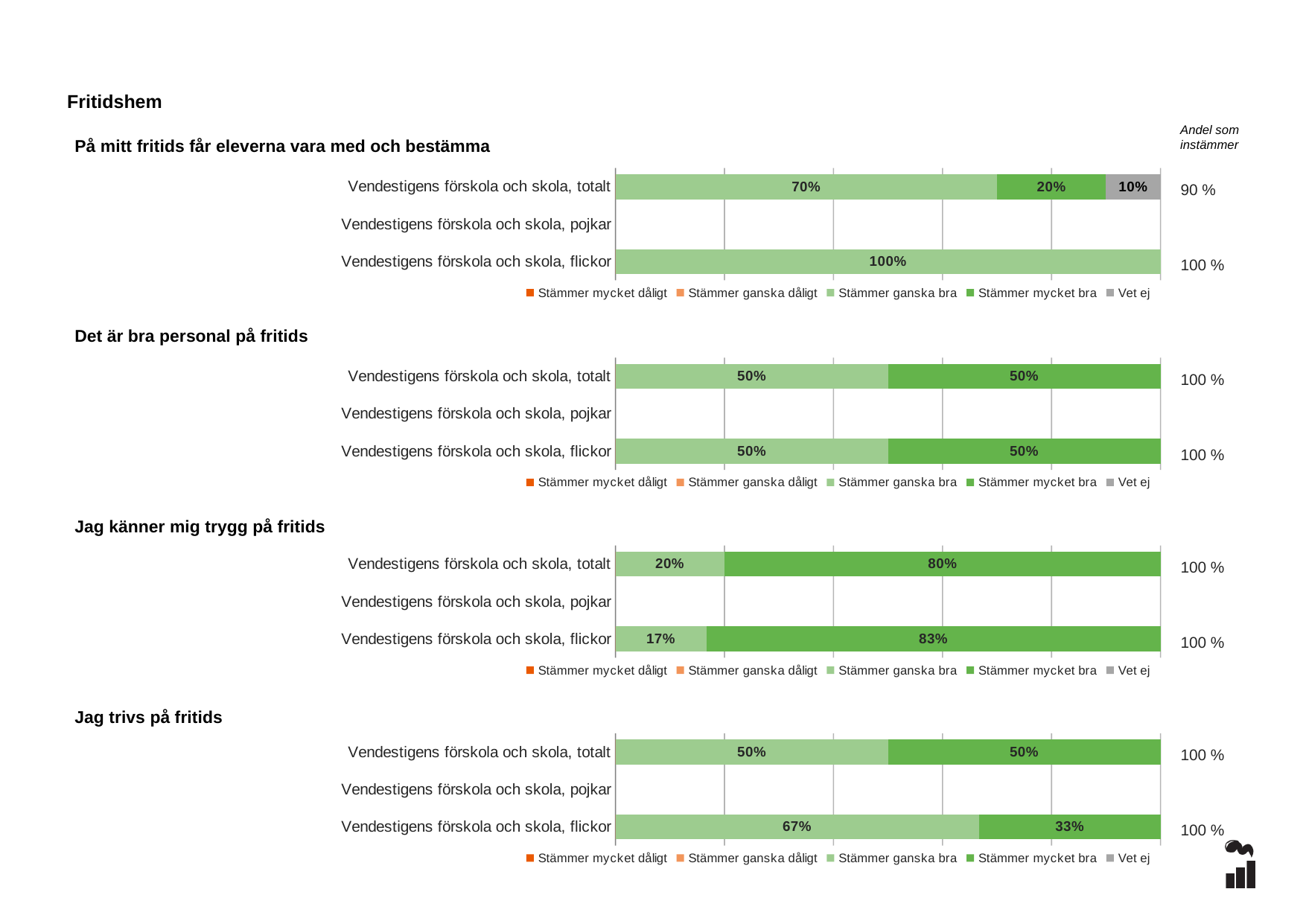
In the chart 'Jag känner mig trygg på fritids', what is the value of 'Stämmer mycket bra' for 'Vendestigens förskola och skola, flickor'? 83% How many categories are shown on the y axis of the chart 'Det är bra personal på fritids'? 3 In the chart 'På mitt fritids får eleverna vara med och bestämma', what is the value of 'Vet ej' for 'Vendestigens förskola och skola, totalt'? 10% In the chart 'Jag trivs på fritids', what is the value of 'Stämmer ganska bra' for 'Vendestigens förskola och skola, flickor'? 67% In the chart 'På mitt fritids får eleverna vara med och bestämma', what is the value of 'Stämmer ganska bra' for 'Vendestigens förskola och skola, flickor'? 100% In the chart 'På mitt fritids får eleverna vara med och bestämma', what is the value of 'Stämmer ganska bra' for 'Vendestigens förskola och skola, totalt'? 70% In the chart 'Det är bra personal på fritids', what is the value of 'Stämmer mycket bra' for 'Vendestigens förskola och skola, totalt'? 50% In the chart 'Jag känner mig trygg på fritids', what is the difference between 'Stämmer mycket bra' and 'Stämmer ganska bra' for 'Vendestigens förskola och skola, totalt'? 60% How many series does the legend of the chart 'Jag trivs på fritids' list? 5 In the chart 'På mitt fritids får eleverna vara med och bestämma', what is the 'Andel som instämmer' value shown for 'Vendestigens förskola och skola, totalt'? 90 % In the chart 'Jag trivs på fritids', which is larger for 'Vendestigens förskola och skola, flickor': 'Stämmer ganska bra' or 'Stämmer mycket bra'? Stämmer ganska bra What kind of chart is 'Jag känner mig trygg på fritids'? Stacked bar chart